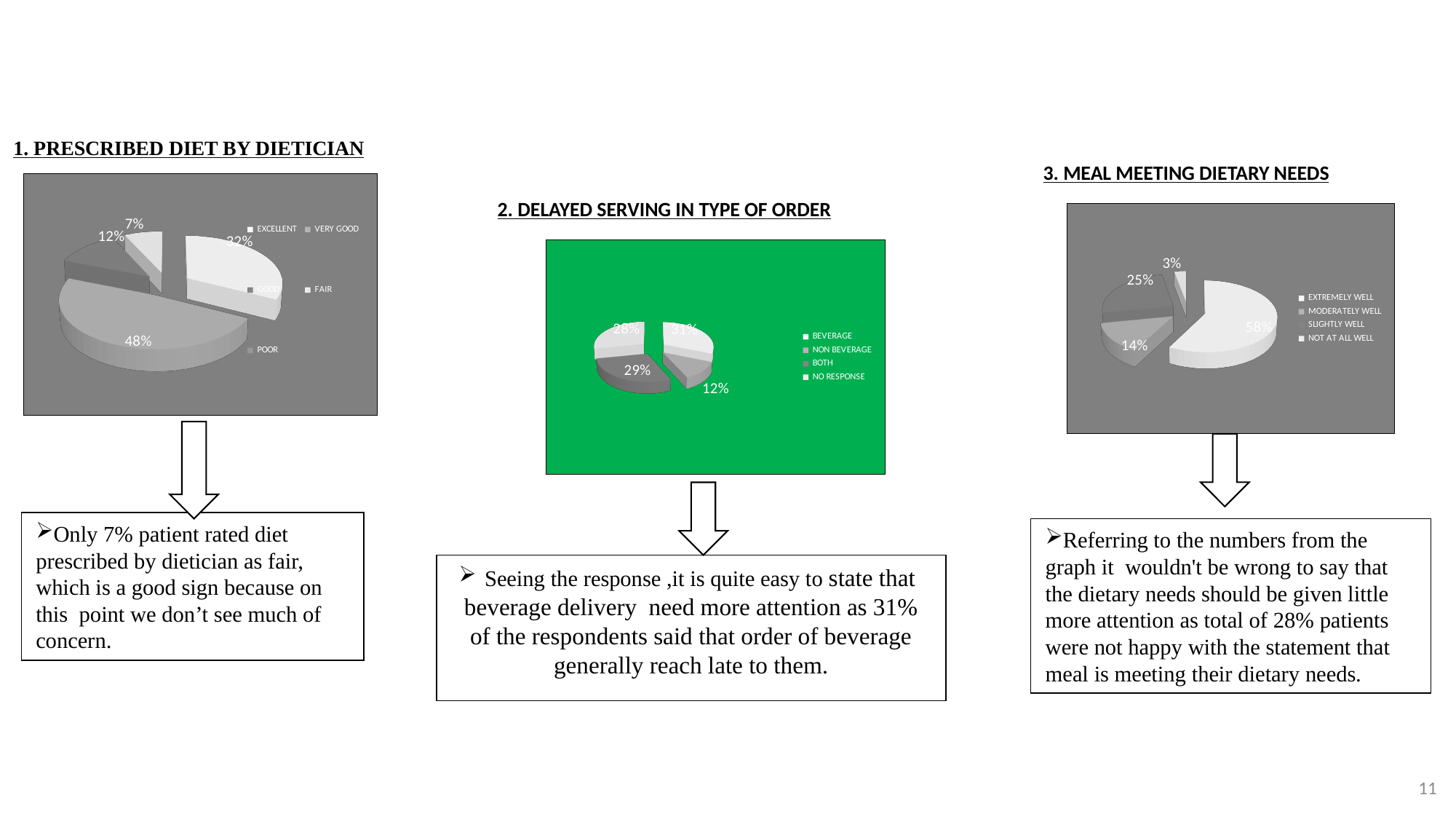
In the 'MEAL MEETING DIETARY NEEDS' chart, what is the difference between the SLIGHTLY WELL and MODERATELY WELL percentages? 11% How many categories does the legend of the 'PRESCRIBED DIET BY DIETICIAN' chart list? 5 What is the background colour of the 'DELAYED SERVING IN TYPE OF ORDER' chart? Green In the 'PRESCRIBED DIET BY DIETICIAN' chart, what percentage of patients rated the diet as FAIR? 7% In the 'DELAYED SERVING IN TYPE OF ORDER' chart, what percentage is shown for BEVERAGE? 31% In the 'DELAYED SERVING IN TYPE OF ORDER' chart, what is the smallest percentage shown on a slice? 12% What type of chart is used in the 'PRESCRIBED DIET BY DIETICIAN' chart? Pie chart In the 'PRESCRIBED DIET BY DIETICIAN' chart, what is the largest percentage shown on a slice? 48% How many categories does the legend of the 'DELAYED SERVING IN TYPE OF ORDER' chart list? 4 In the 'MEAL MEETING DIETARY NEEDS' chart, what percentage is shown for EXTREMELY WELL? 58% In the 'MEAL MEETING DIETARY NEEDS' chart, what percentage is shown for NOT AT ALL WELL? 3% In the 'MEAL MEETING DIETARY NEEDS' chart, which category has the largest share? EXTREMELY WELL